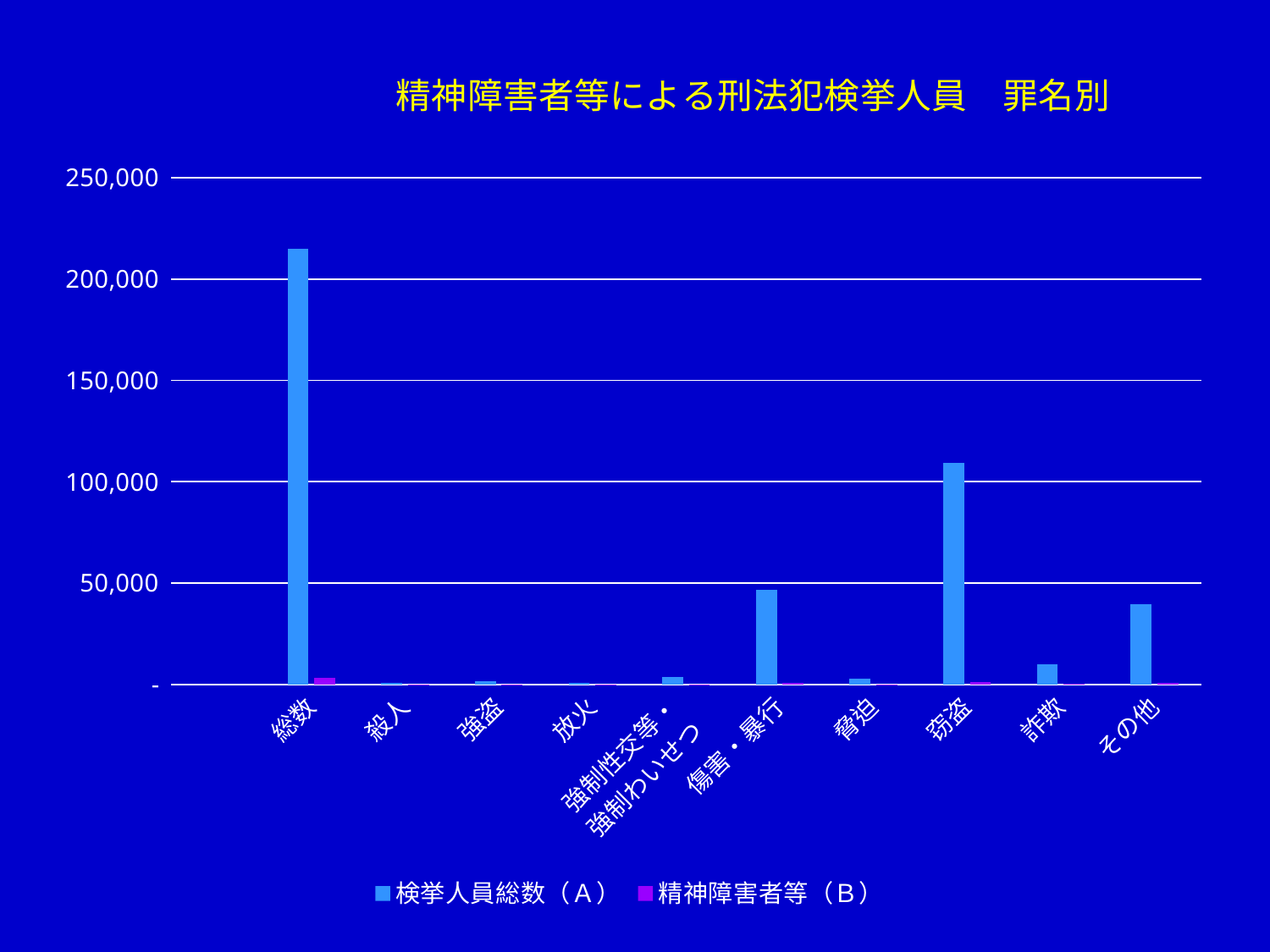
How many series does the legend list? 2 Which series is shown in purple according to the legend? 精神障害者等（B） What is the title of the chart? 精神障害者等による刑法犯検挙人員 罪名別 Is the value of 検挙人員総数（A） for 傷害・暴行 greater or less than 50,000? less Is the value of 検挙人員総数（A） for 窃盗 greater or less than 100,000? greater Which is larger for 検挙人員総数（A）: 窃盗 or 傷害・暴行? 窃盗 How many categories are shown along the x axis? 10 What kind of chart is shown on the slide? bar chart Is the value of 検挙人員総数（A） for 総数 greater or less than 200,000? greater Which category has the highest value for 検挙人員総数（A）? 総数 Which is larger for 検挙人員総数（A）: その他 or 詐欺? その他